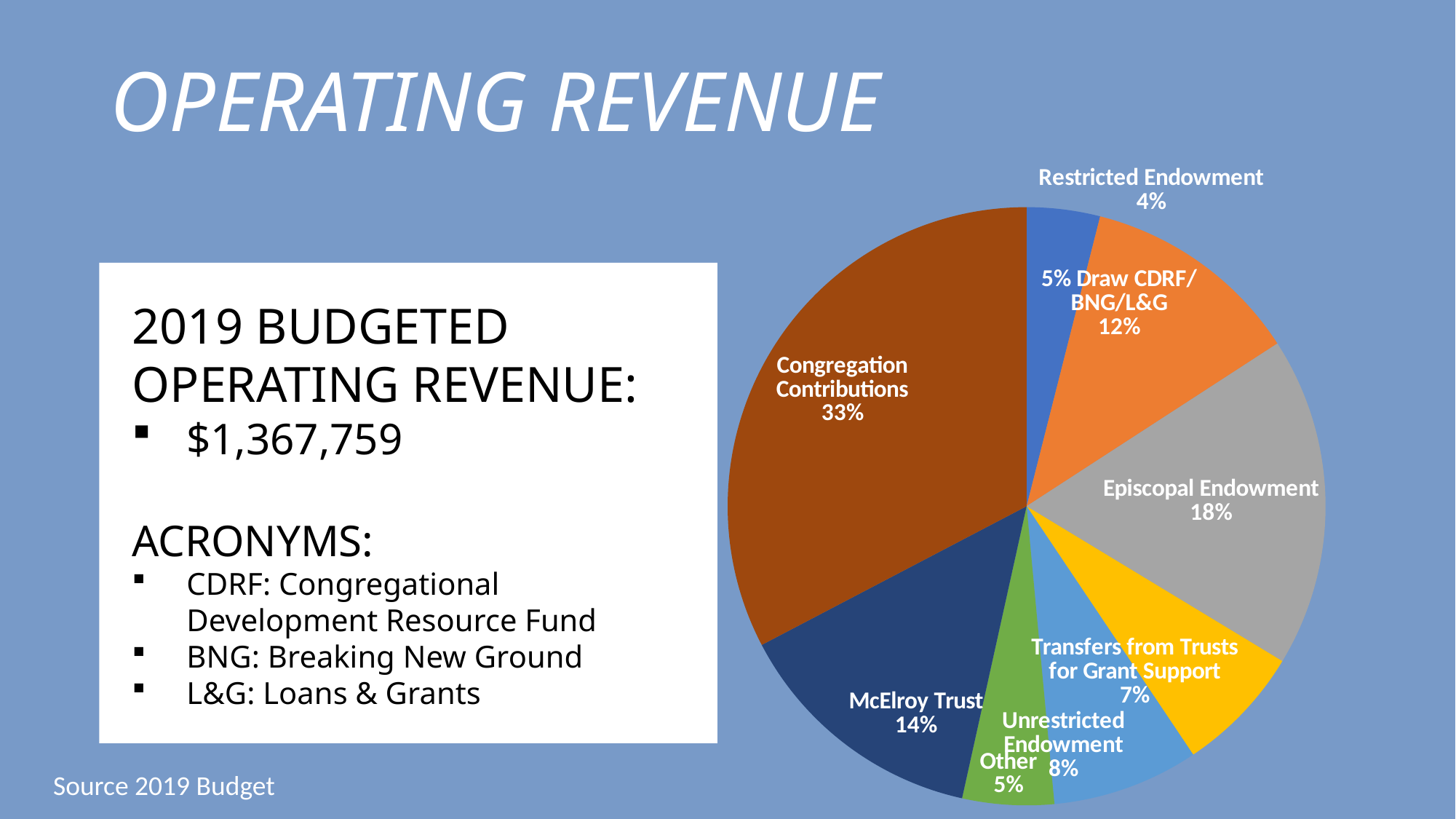
What share of operating revenue comes from Congregation Contributions? 33% What share of operating revenue comes from the Restricted Endowment? 4% Which slice of the pie chart is the largest? Congregation Contributions What type of chart is shown on the slide? pie chart What share of operating revenue comes from Transfers from Trusts for Grant Support? 7% What colour is the Congregation Contributions slice? brown What is the difference in percentage points between Congregation Contributions and the Episcopal Endowment? 15 Which slice of the pie chart is the smallest? Restricted Endowment How many slices does the pie chart have? 8 Which is larger, the Unrestricted Endowment share or the Other share? Unrestricted Endowment